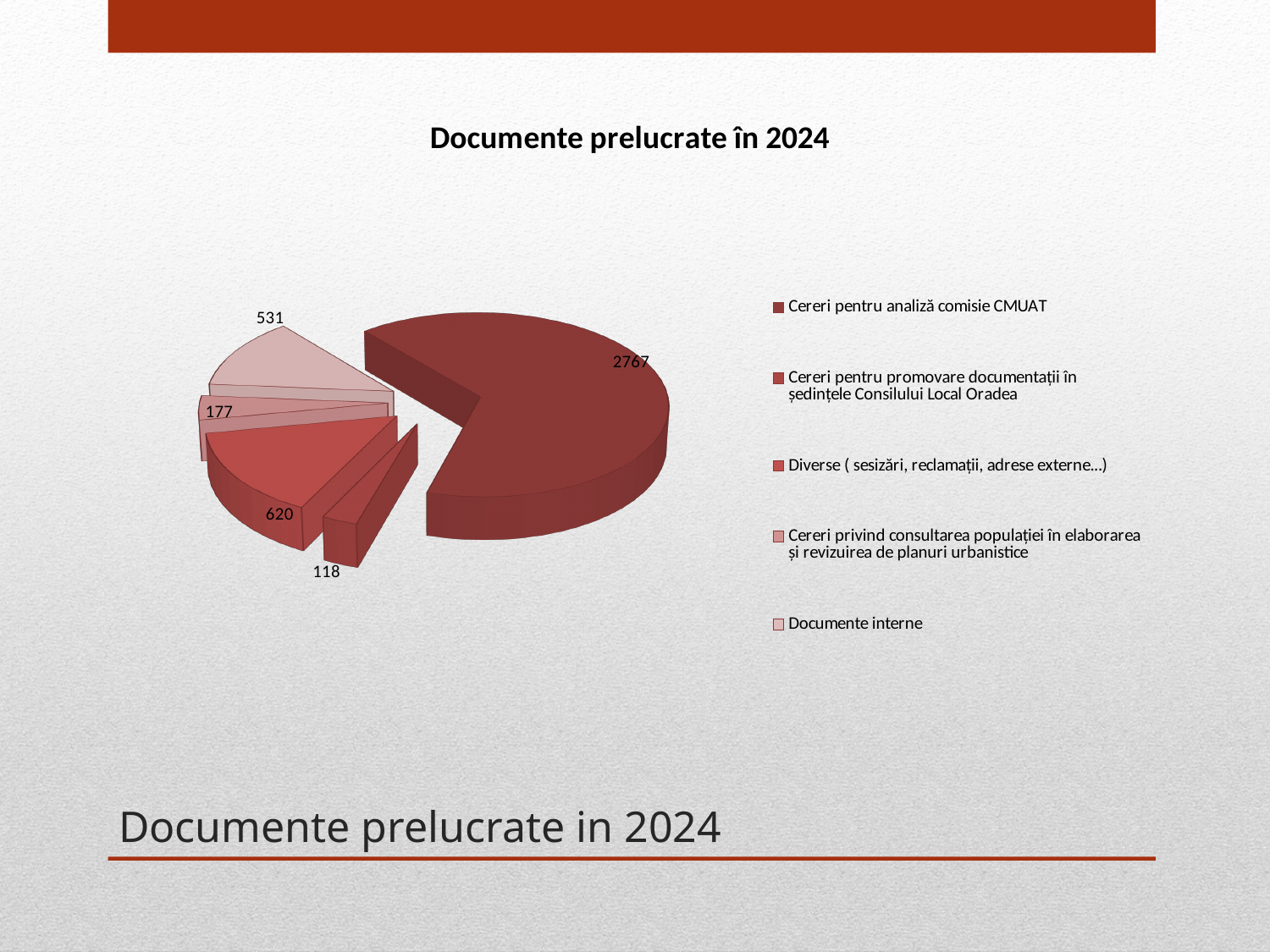
What is the difference between the value for Cereri pentru analiză comisie CMUAT and the value for Diverse? 2147 What is the title of the chart? Documente prelucrate în 2024 What kind of chart is shown on the slide? pie chart Which is larger: the value for Documente interne or the value for Cereri privind consultarea populației în elaborarea și revizuirea de planuri urbanistice? Documente interne What is the total of all the values shown in the pie chart? 4213 Which category has the smallest slice? Cereri pentru promovare documentații în ședințele Consilului Local Oradea How many slices does the pie chart have? 5 What is the value for Diverse (sesizări, reclamații, adrese externe...)? 620 What is the value for Cereri pentru promovare documentații în ședințele Consilului Local Oradea? 118 What is the value for Documente interne? 531 What is the value for Cereri pentru analiză comisie CMUAT? 2767 Which category has the largest slice? Cereri pentru analiză comisie CMUAT